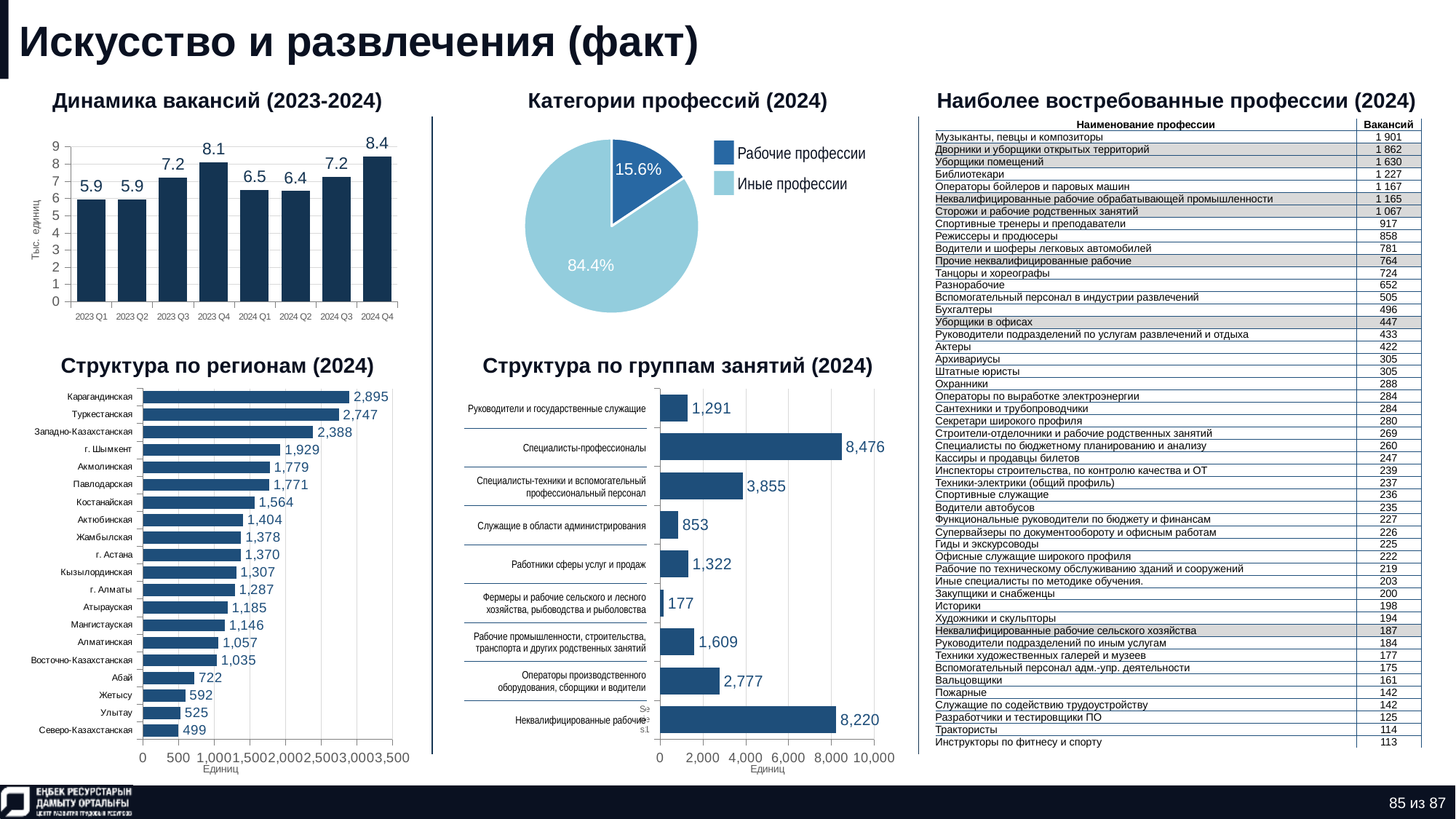
In the chart 'Динамика вакансий (2023-2024)', which quarter has the highest value? 2024 Q4 In the chart 'Структура по регионам (2024)', what is the value for 'г. Астана'? 1,370 In the chart 'Динамика вакансий (2023-2024)', what is the value for 2024 Q4? 8.4 In the chart 'Структура по группам занятий (2024)', which is larger: 'Специалисты-профессионалы' or 'Неквалифицированные рабочие'? Специалисты-профессионалы In the pie chart 'Категории профессий (2024)', what share does 'Рабочие профессии' have? 15.6% In the pie chart 'Категории профессий (2024)', how many entries does the legend list? 2 In the chart 'Динамика вакансий (2023-2024)', what is the difference between the values for 2023 Q4 and 2023 Q3? 0.9 In the chart 'Структура по группам занятий (2024)', what is the value for 'Специалисты-профессионалы'? 8,476 In the chart 'Структура по регионам (2024)', what is the difference between the values for Карагандинская and Туркестанская? 148 In the chart 'Структура по регионам (2024)', which region has the highest value? Карагандинская In the chart 'Структура по регионам (2024)', which region has the lowest value? Северо-Казахстанская In the chart 'Динамика вакансий (2023-2024)', how many quarters are plotted? 8